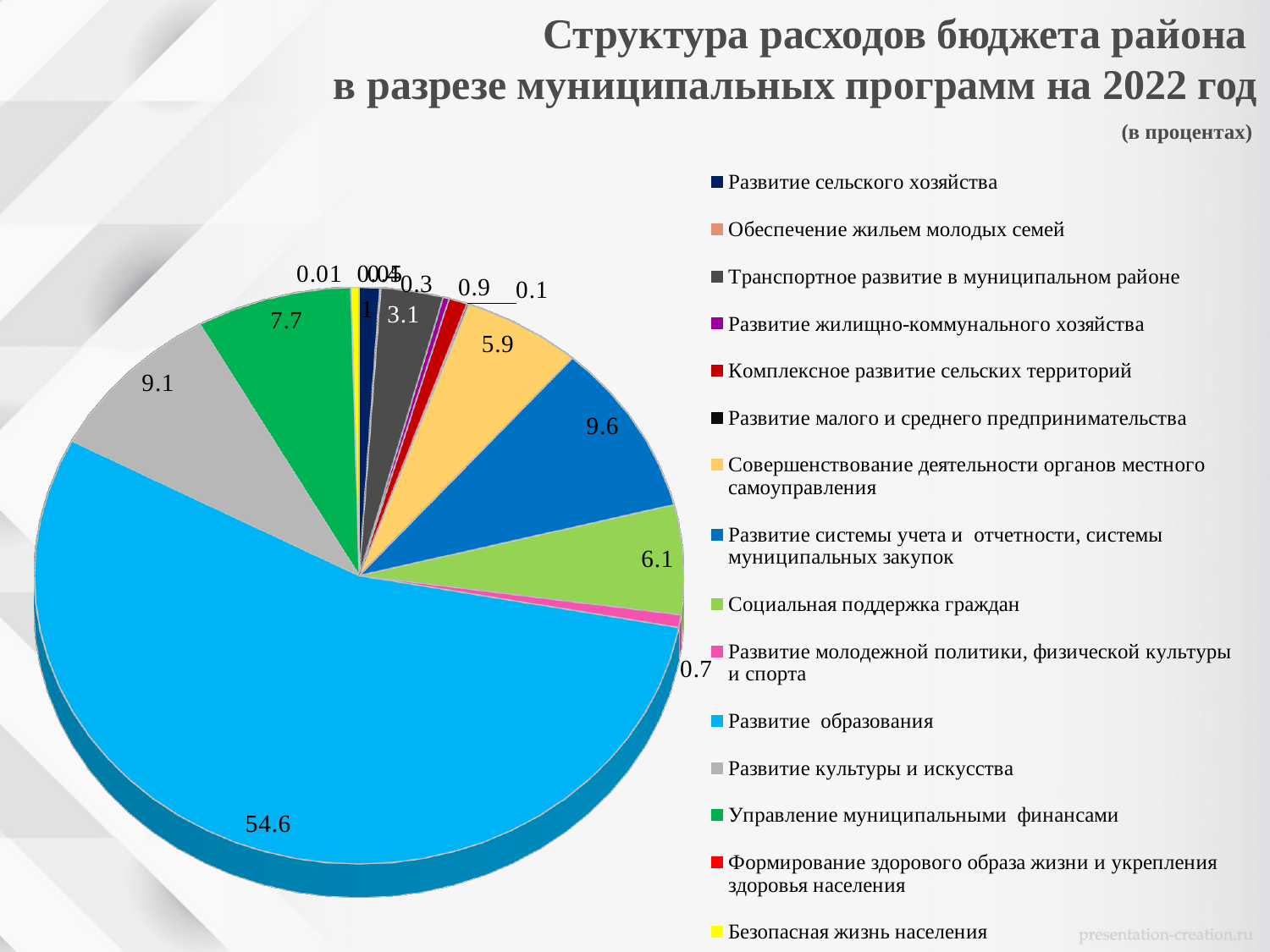
What is the value shown for Развитие образования? 54.6 What is the value shown for Социальная поддержка граждан? 6.1 What is the value shown for Управление муниципальными финансами? 7.7 What is the title of the chart on the slide? Структура расходов бюджета района в разрезе муниципальных программ на 2022 год What is the difference between the values for Развитие образования and Развитие культуры и искусства? 45.5 How many entries does the legend of the pie chart list? 15 What is the value shown for Развитие системы учета и отчетности, системы муниципальных закупок? 9.6 What is the value shown for Совершенствование деятельности органов местного самоуправления? 5.9 Which program has the largest share of the district budget expenditures in the pie chart? Развитие образования What kind of chart is shown on the slide? pie chart Which is larger: the value for Развитие культуры и искусства or for Управление муниципальными финансами? Развитие культуры и искусства What is the value shown for Развитие культуры и искусства? 9.1